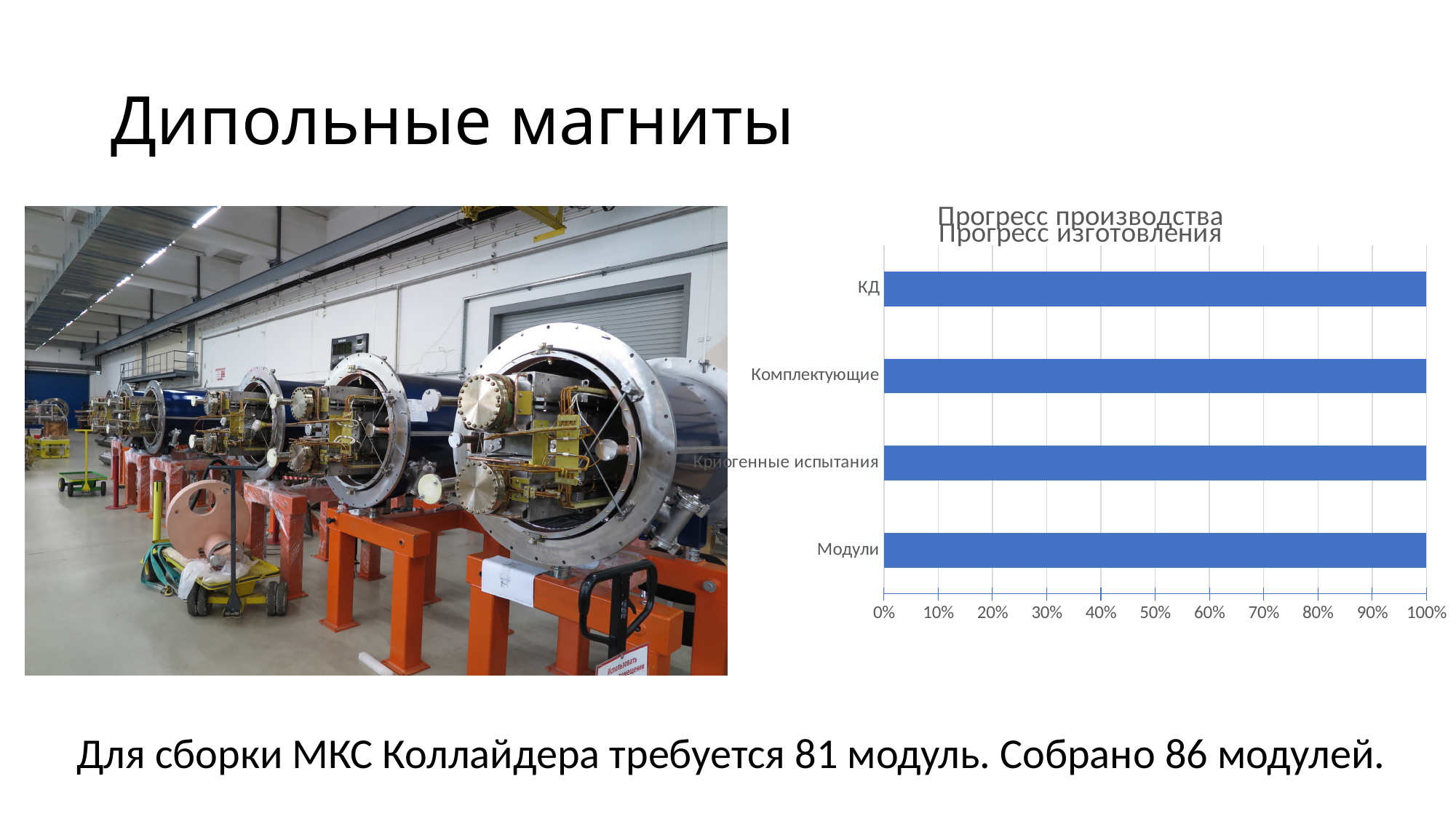
What is the difference between the values for КД and Модули? 0% Is the value for Модули greater or less than 50%? greater What is the value for Комплектующие in the bar chart? 100% What is the value for Модули in the bar chart? 100% What is the value for Криогенные испытания in the bar chart? 100% What kind of chart is shown on the slide? bar chart What is the highest value shown on the x axis of the bar chart? 100% What is the value for КД in the bar chart? 100% Which category is listed at the top of the bar chart? КД How many categories does the bar chart show? 4 Is the value for Криогенные испытания greater or less than 90%? greater